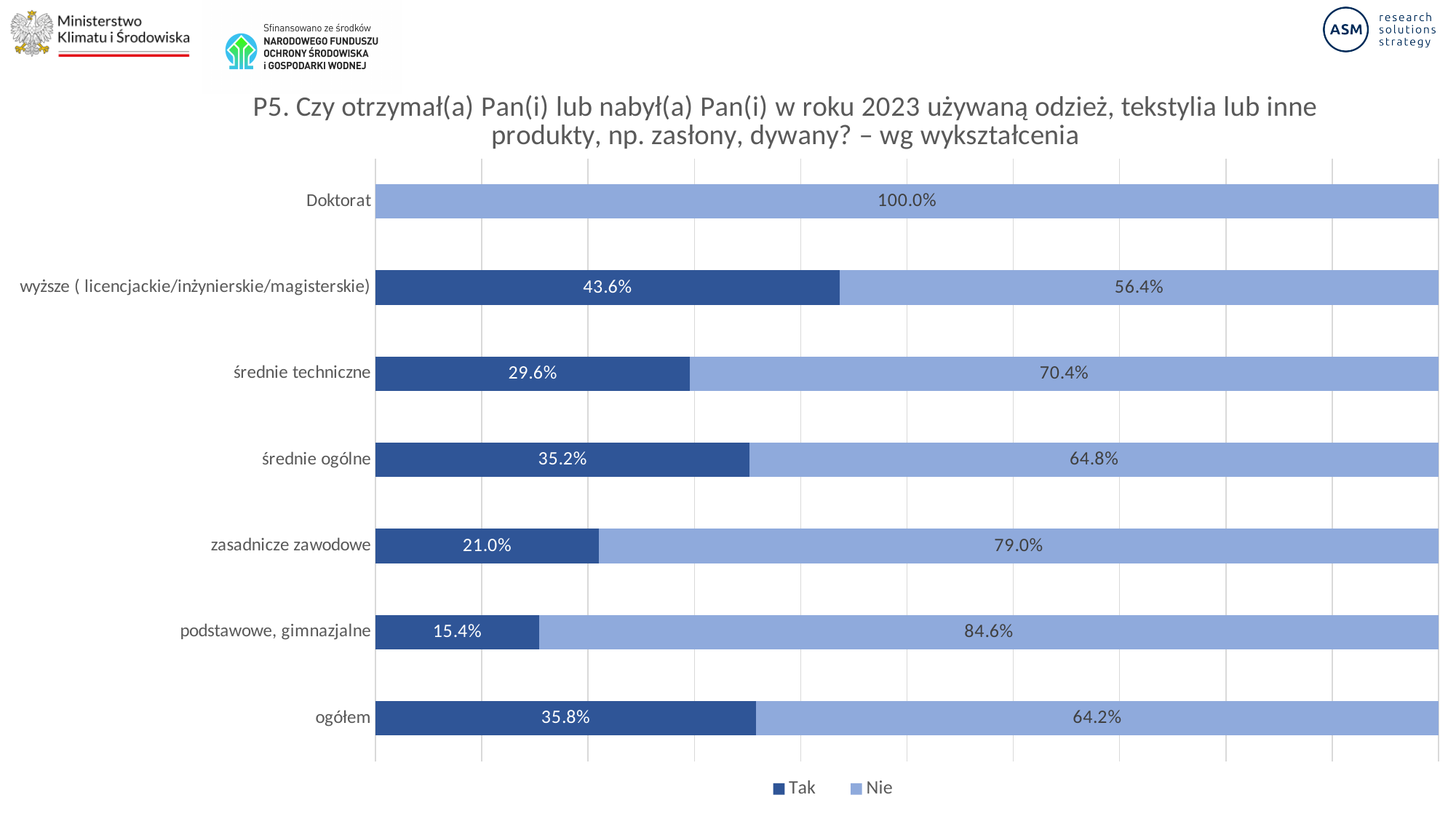
Which category has the lowest 'Nie' value? wyższe ( licencjackie/inżynierskie/magisterskie) What are the two legend entries of the chart? Tak, Nie What is the difference between the 'Nie' values for 'podstawowe, gimnazjalne' and 'średnie ogólne'? 19.8% How many education categories are shown on the chart? 7 Which is larger: the 'Tak' value for 'średnie techniczne' or for 'średnie ogólne'? średnie ogólne Which category has the highest 'Tak' value? wyższe ( licencjackie/inżynierskie/magisterskie) What is the 'Nie' value for 'zasadnicze zawodowe'? 79.0% What is the 'Nie' value for 'Doktorat'? 100.0% How many series does the legend list? 2 What is the 'Tak' value for 'wyższe ( licencjackie/inżynierskie/magisterskie)'? 43.6% What kind of chart is shown on the slide? stacked bar chart What is the 'Tak' value for 'ogółem'? 35.8%